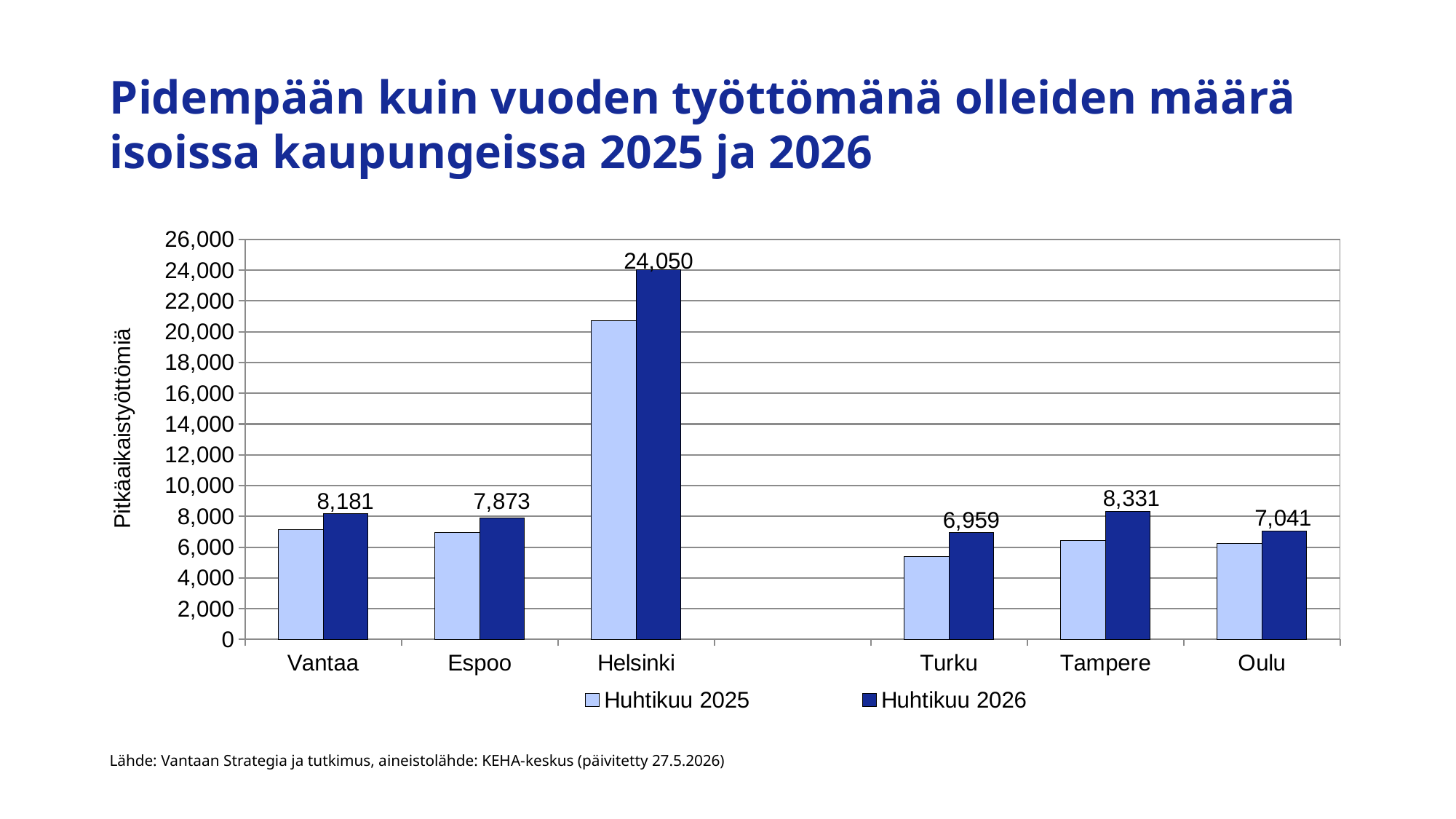
What is the Huhtikuu 2026 value for Vantaa? 8,181 What is the difference between the Huhtikuu 2026 values for Tampere and Oulu? 1,290 Which city has the highest Huhtikuu 2026 value? Helsinki What kind of chart is shown on the slide? Bar chart Which city has the lowest Huhtikuu 2026 value? Turku How many series does the legend list? 2 What is the Huhtikuu 2026 value for Helsinki? 24,050 What is the Huhtikuu 2026 value for Turku? 6,959 Is the Huhtikuu 2025 value for Helsinki greater or less than 20,000? greater Is the Huhtikuu 2025 value for Turku greater or less than 6,000? less How many cities are shown on the x axis? 6 Which is larger, the Huhtikuu 2026 value for Espoo or for Tampere? Tampere